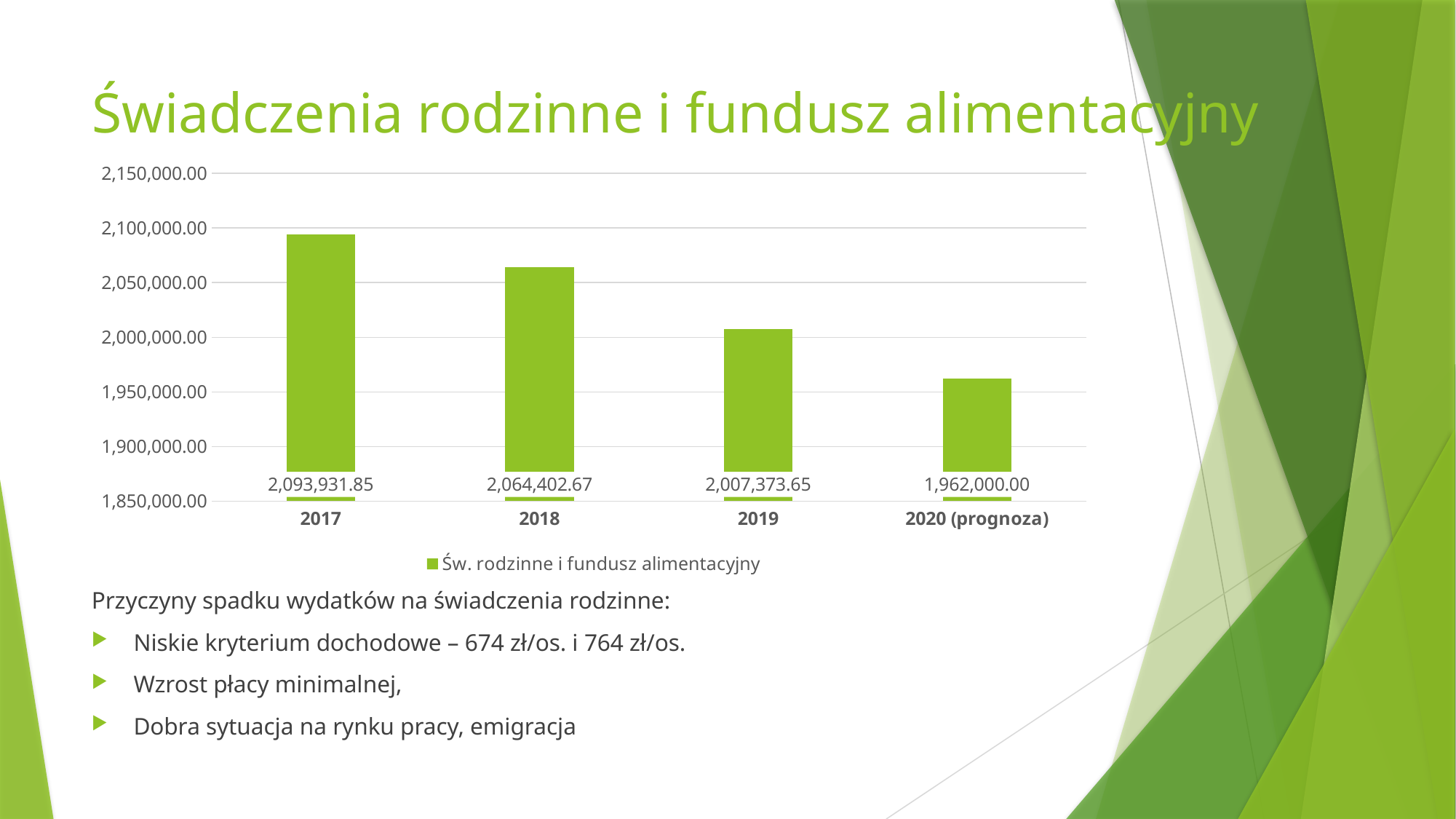
Do the values rise or fall from 2017 to 2020 (prognoza)? fall Which category has the lowest value? 2020 (prognoza) What is the difference between the values for 2017 and 2020 (prognoza)? 131,931.85 What is the difference between the values for 2017 and 2018? 29,529.18 What is the value for 2017? 2,093,931.85 What is the value for 2019? 2,007,373.65 What is the value for 2020 (prognoza)? 1,962,000.00 Which is larger, the value for 2018 or the value for 2019? 2018 How many categories are shown on the x axis? 4 Is the value for 2019 greater or less than 2,050,000.00? less Which year has the highest value? 2017 What is the value for 2018? 2,064,402.67